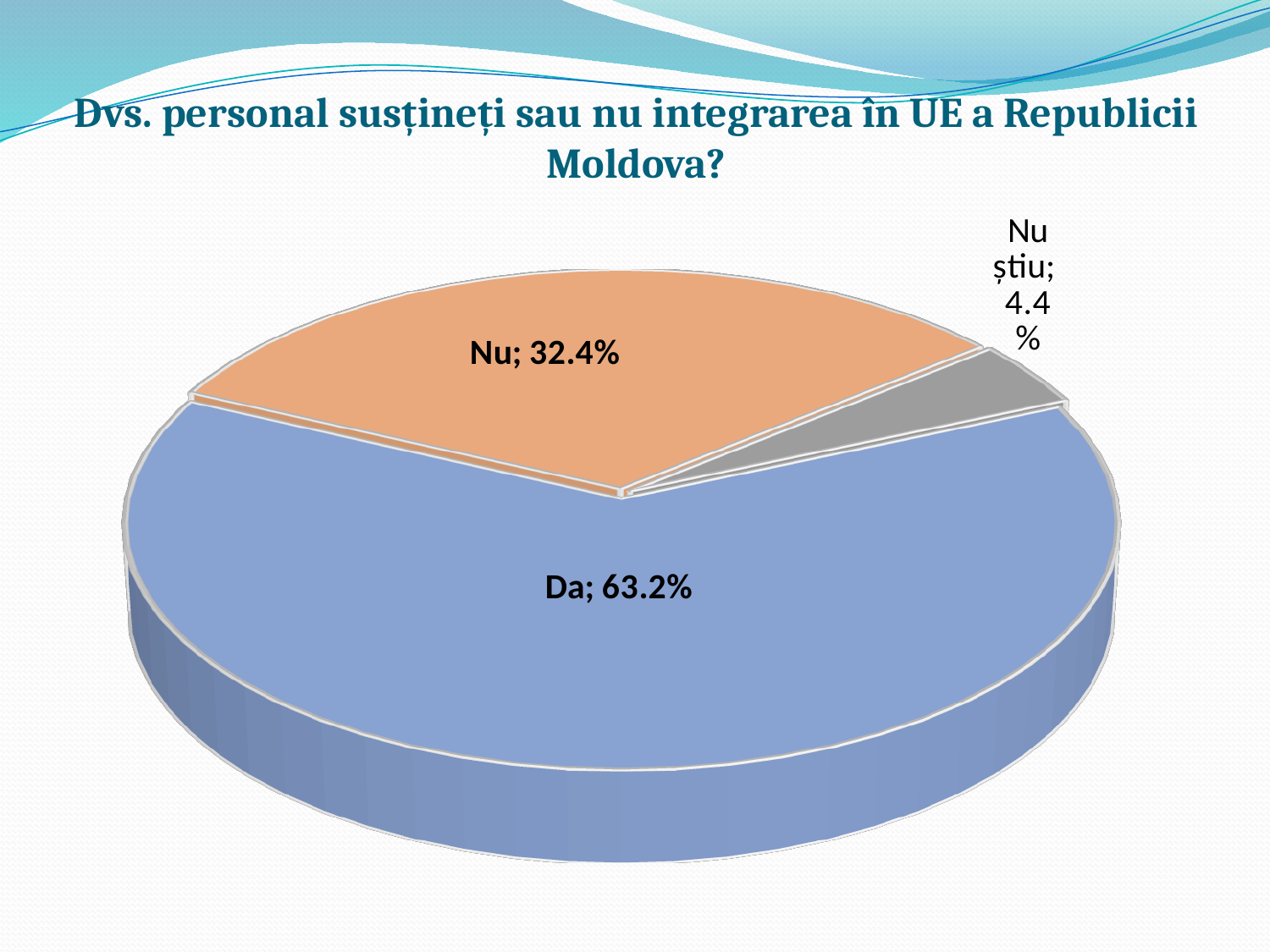
Which response has the smallest share of the pie? Nu știu What kind of chart is shown on the slide? Pie chart How many slices does the pie chart have? 3 Is the share for "Da" greater or less than 50%? greater What percentage of respondents answered "Nu"? 32.4% What colour is the "Nu" slice? Orange What is the difference in percentage points between the "Da" and "Nu" shares? 30.8 Which is larger, the share for "Nu" or the share for "Nu știu"? Nu What percentage of respondents answered "Nu știu"? 4.4% What percentage of respondents answered "Da"? 63.2% What is the title of the chart? Dvs. personal susțineți sau nu integrarea în UE a Republicii Moldova? Which response has the largest share of the pie? Da